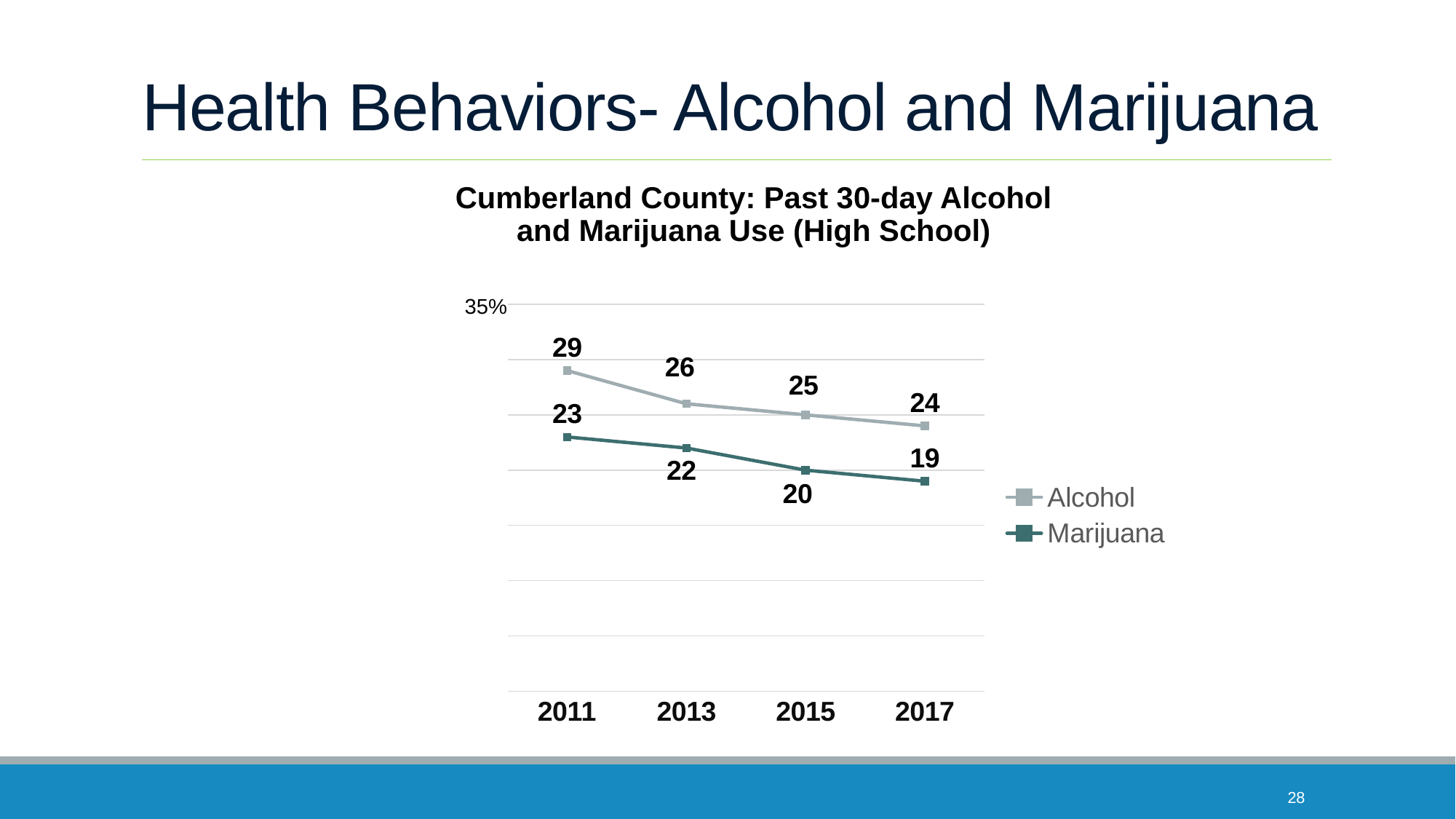
Which is larger in 2017, the Alcohol value or the Marijuana value? Alcohol What is the Marijuana value for 2017? 19 What is the difference between the Alcohol and Marijuana values in 2011? 6 How many series does the legend list? 2 In which year is the Alcohol value highest? 2011 Do the Alcohol values rise or fall from 2011 to 2017? Fall What is the Alcohol value for 2011? 29 What is the Alcohol value for 2015? 25 What kind of chart is shown on the slide? Line chart How many years are shown on the x axis? 4 What is the Marijuana value for 2013? 22 In which year is the Marijuana value lowest? 2017